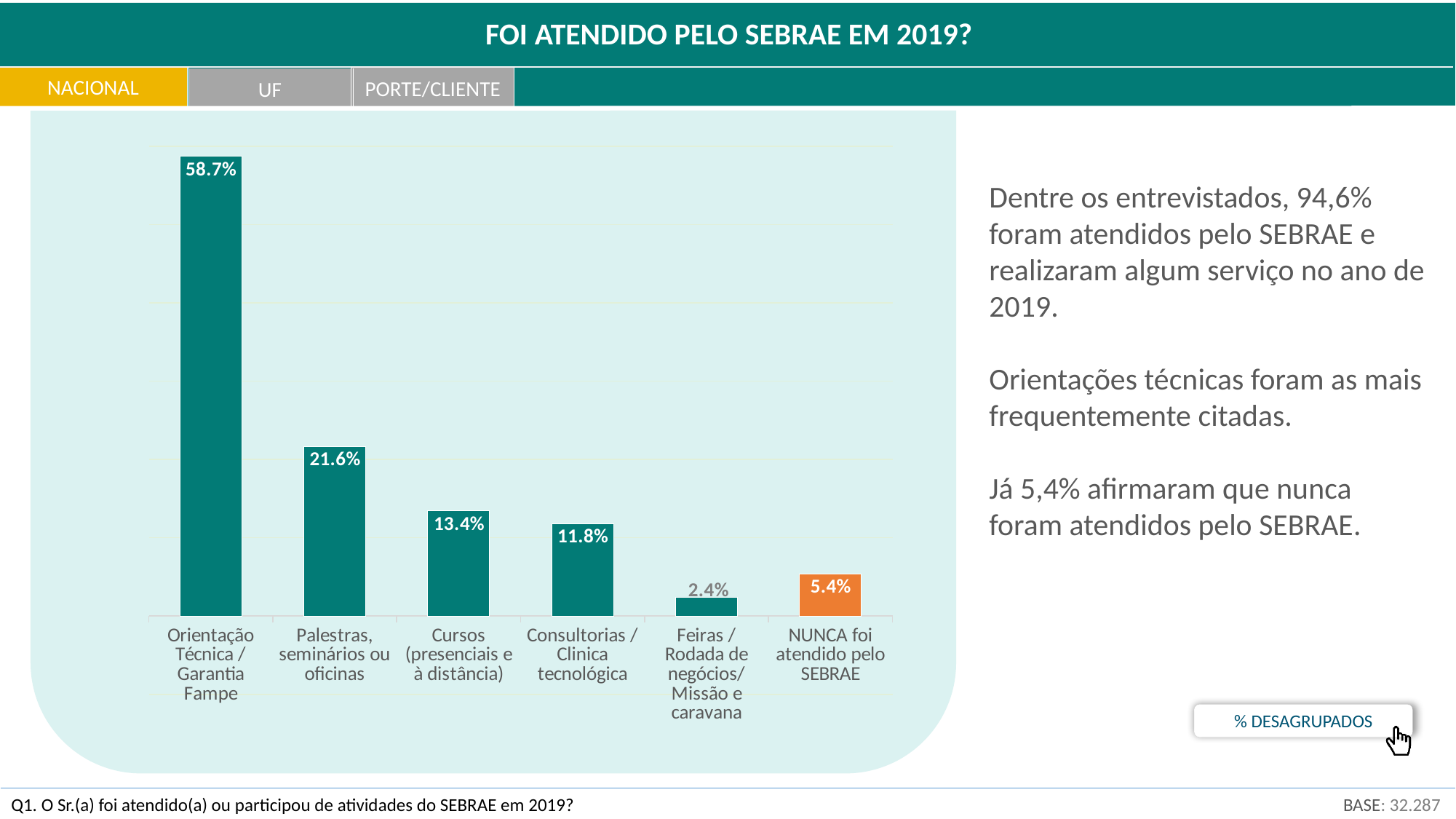
What is the value for Orientação Técnica / Garantia Fampe? 58.7% What is the value for NUNCA foi atendido pelo SEBRAE? 5.4% Which category has the highest value? Orientação Técnica / Garantia Fampe What is the difference between Orientação Técnica / Garantia Fampe and Palestras, seminários ou oficinas? 37.1% What is the value for Consultorias / Clinica tecnológica? 11.8% Which category has the lowest value? Feiras / Rodada de negócios/ Missão e caravana What is the value for Palestras, seminários ou oficinas? 21.6% Which bar is coloured orange instead of teal? NUNCA foi atendido pelo SEBRAE What is the value for Cursos (presenciais e à distância)? 13.4% Which is larger: Cursos (presenciais e à distância) or Consultorias / Clinica tecnológica? Cursos (presenciais e à distância) What kind of chart is shown on the slide? Bar chart How many categories are shown in the chart? 6